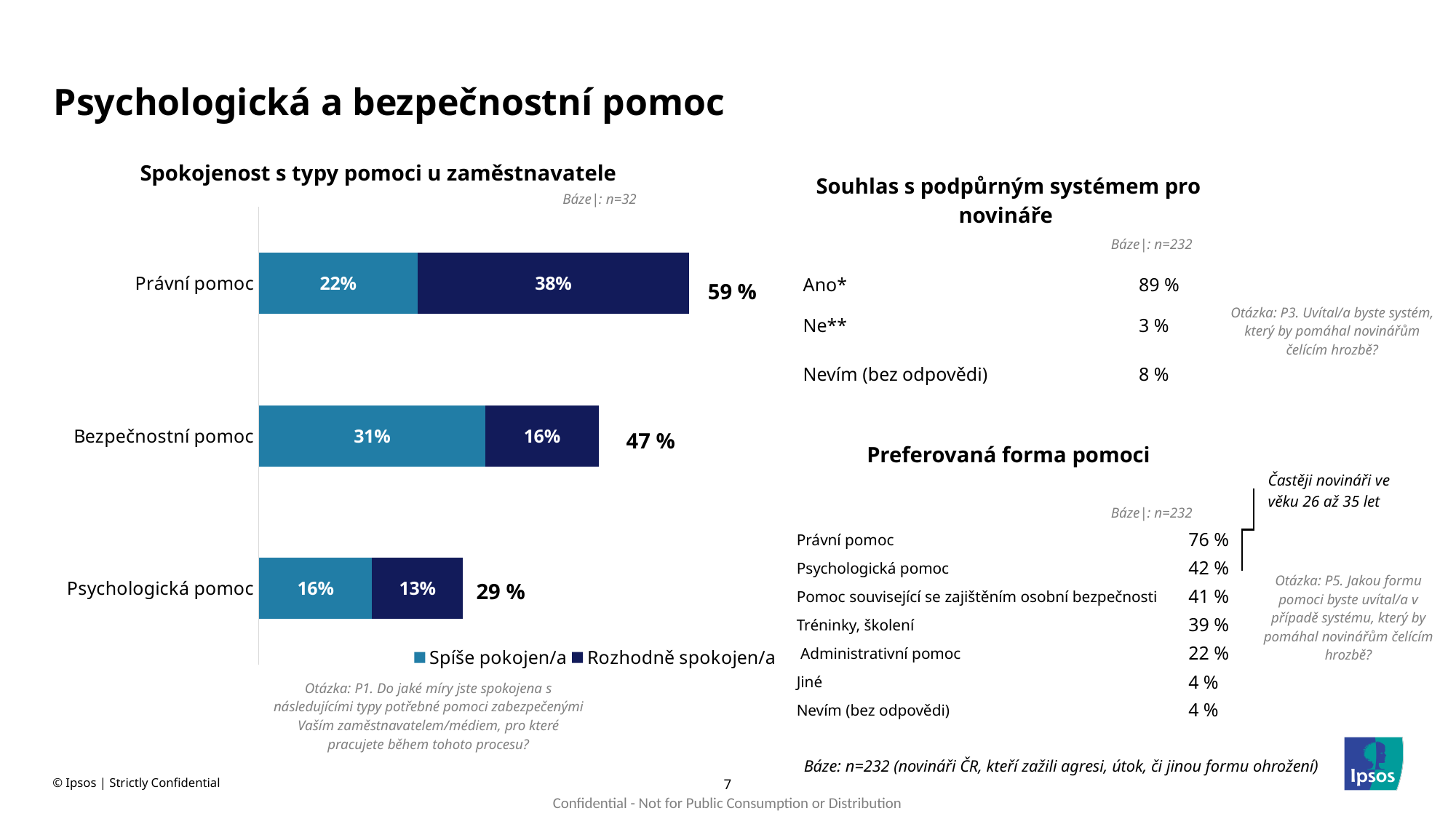
How many categories does the chart 'Spokojenost s typy pomoci u zaměstnavatele' show? 3 In the chart 'Spokojenost s typy pomoci u zaměstnavatele', which is larger for Bezpečnostní pomoc: 'Spíše pokojen/a' or 'Rozhodně spokojen/a'? Spíše pokojen/a In the chart 'Spokojenost s typy pomoci u zaměstnavatele', what is the 'Rozhodně spokojen/a' value for Psychologická pomoc? 13% In the chart 'Spokojenost s typy pomoci u zaměstnavatele', which category has the highest total? Právní pomoc In the chart 'Spokojenost s typy pomoci u zaměstnavatele', which category has the lowest total? Psychologická pomoc What is the base (Báze) stated for the chart 'Spokojenost s typy pomoci u zaměstnavatele'? n=32 In the chart 'Spokojenost s typy pomoci u zaměstnavatele', what is the 'Spíše pokojen/a' value for Právní pomoc? 22% In the chart 'Spokojenost s typy pomoci u zaměstnavatele', what is the total shown for the Bezpečnostní pomoc bar? 47 % What kind of chart is 'Spokojenost s typy pomoci u zaměstnavatele'? Stacked bar chart How many series does the legend of the chart 'Spokojenost s typy pomoci u zaměstnavatele' list? 2 In the chart 'Spokojenost s typy pomoci u zaměstnavatele', what is the difference between the 'Rozhodně spokojen/a' values for Právní pomoc and Bezpečnostní pomoc? 22 percentage points In the chart 'Spokojenost s typy pomoci u zaměstnavatele', what is the 'Rozhodně spokojen/a' value for Bezpečnostní pomoc? 16%